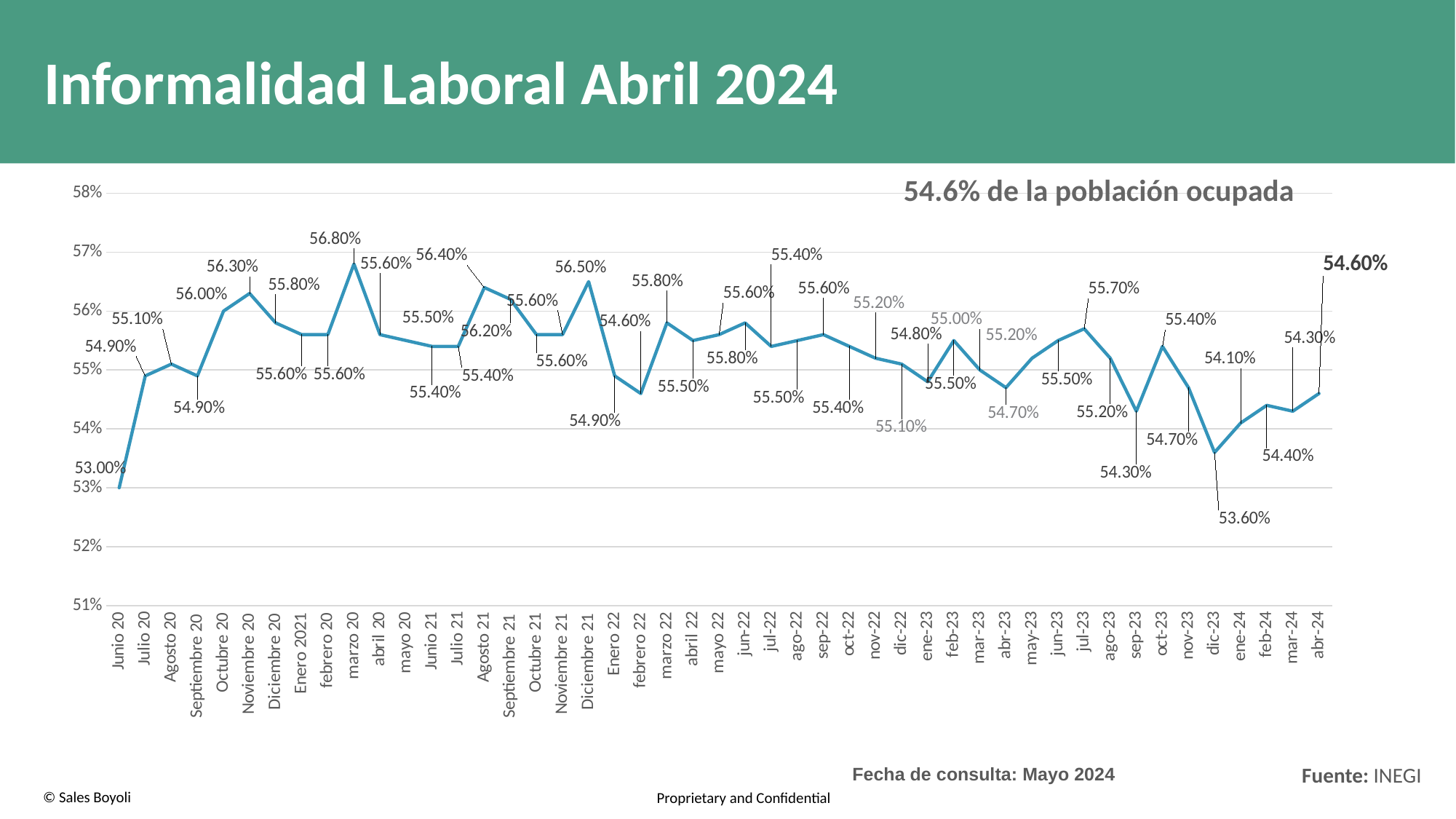
Which is larger, the value for Diciembre 21 or the value for Enero 22? Diciembre 21 What is the value for Junio 20? 53.00% Which month has the highest value on the chart? marzo 20 Is the value for sep-23 greater or less than 55%? less What is the value for dic-23? 53.60% What kind of chart is shown on the slide? Line chart What is the difference between the values for abr-24 and mar-24? 0.30% Do the values rise or fall from dic-23 to abr-24? Rise What is the difference between the highest value (marzo 20) and the lowest value (Junio 20)? 3.80% Which month has the lowest value on the chart? Junio 20 How many data points are plotted on the chart? 47 What is the value for abr-24? 54.60%